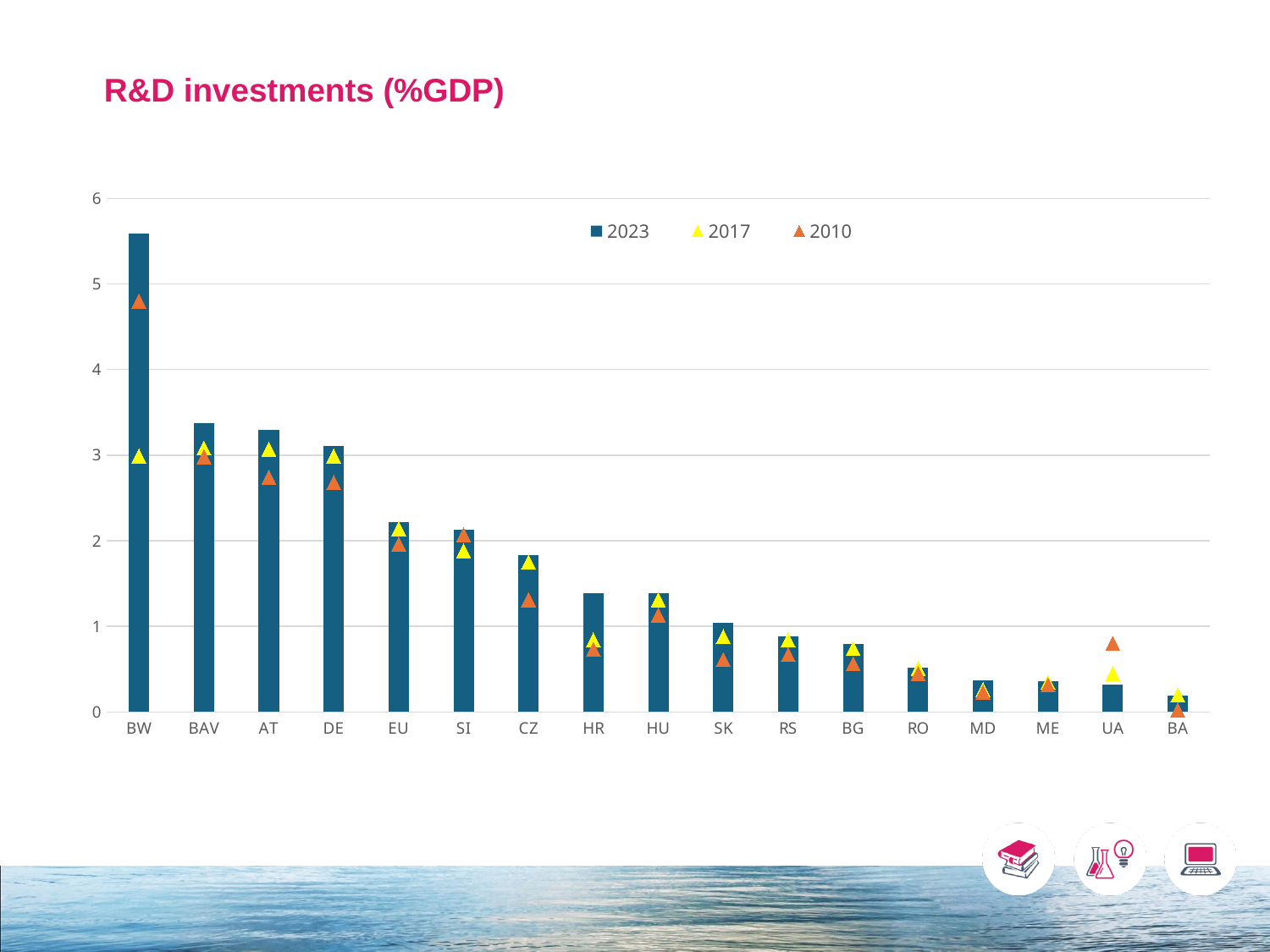
Is the 2023 value for BW greater or less than 5? greater Is the 2023 value for EU greater or less than 2? greater What kind of chart is shown on the slide? bar chart Which category has the highest 2023 value? BW Which has the larger 2023 value, CZ or HR? CZ Do the 2023 bars rise or fall from left to right along the x axis? fall Which category has the lowest 2023 value? BA What is the title of the chart? R&D investments (%GDP) How many categories are shown on the x axis? 17 How many series does the legend list? 3 Is the 2010 value for UA greater or less than 1? less